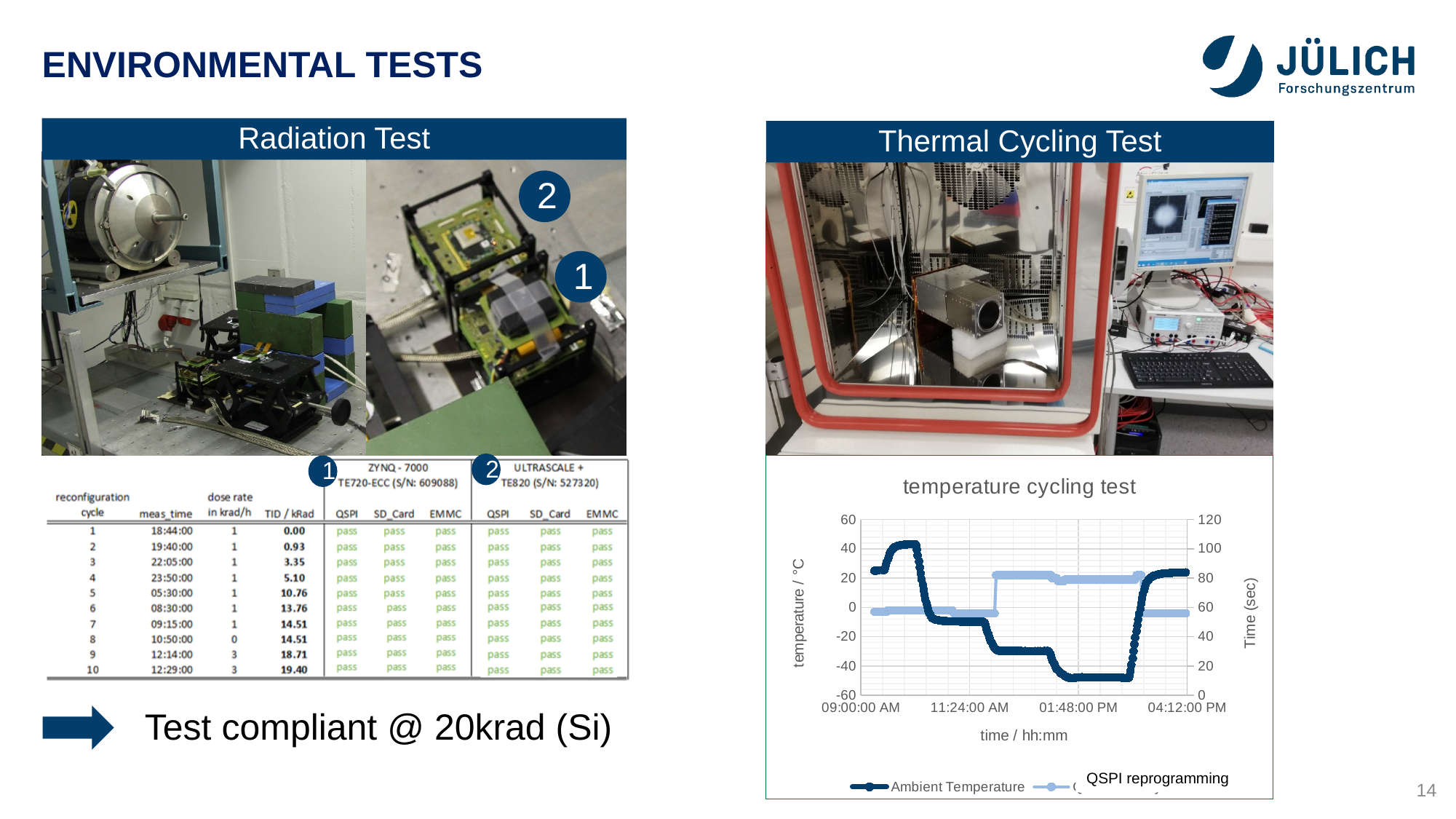
What is the label of the left vertical axis of the "temperature cycling test" chart? temperature / °C In the "temperature cycling test" chart, does the ambient temperature rise or fall between 11:24:00 AM and 01:48:00 PM? fall In the "temperature cycling test" chart, which series is plotted in dark blue? Ambient Temperature In the "temperature cycling test" chart, is the QSPI reprogramming time at 01:48:00 PM greater or less than 60 seconds? greater In the "temperature cycling test" chart, is the ambient temperature at the start of the test (around 09:00 AM) greater or less than 20? greater How many series does the legend of the "temperature cycling test" chart list? 2 What is the title of the chart on the right side of the slide? temperature cycling test In the "temperature cycling test" chart, is the ambient temperature at 01:48:00 PM greater or less than -20? less In the "temperature cycling test" chart, does the ambient temperature rise or fall between 01:48:00 PM and 04:12:00 PM? rise What kind of chart is the "temperature cycling test" chart? line chart